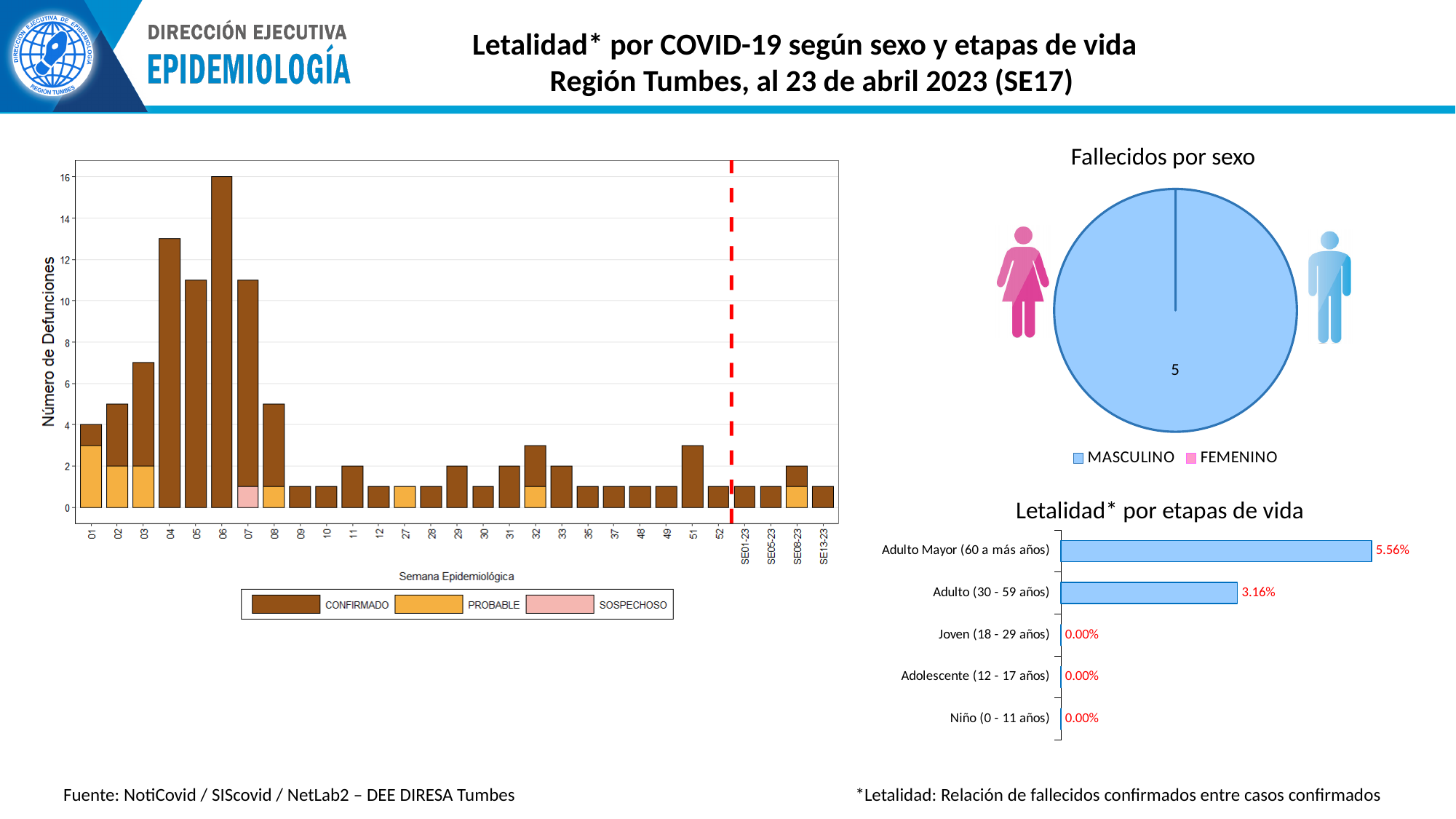
How many series does the legend of the bar chart on the left (Número de Defunciones by Semana Epidemiológica) list? 3 In the bar chart on the left, is the number of deaths for week 04 greater or less than 12? greater In the "Letalidad* por etapas de vida" chart, what is the difference between the values for Adulto Mayor (60 a más años) and Adulto (30 - 59 años)? 2.40% In the bar chart on the left, which epidemiological week has the highest number of deaths? 06 In the bar chart on the left, what is the number of deaths for week 06? 16 In the "Letalidad* por etapas de vida" chart, what is the value for Adulto (30 - 59 años)? 3.16% What kind of chart is the "Letalidad* por etapas de vida" chart at the bottom right? bar chart How many age groups are shown in the "Letalidad* por etapas de vida" chart? 5 How many series does the legend of the "Fallecidos por sexo" pie chart list? 2 In the "Letalidad* por etapas de vida" chart, which age group has the highest value? Adulto Mayor (60 a más años) In the "Letalidad* por etapas de vida" chart, what is the value for Adulto Mayor (60 a más años)? 5.56% In the "Fallecidos por sexo" pie chart, what value is printed on the MASCULINO slice? 5